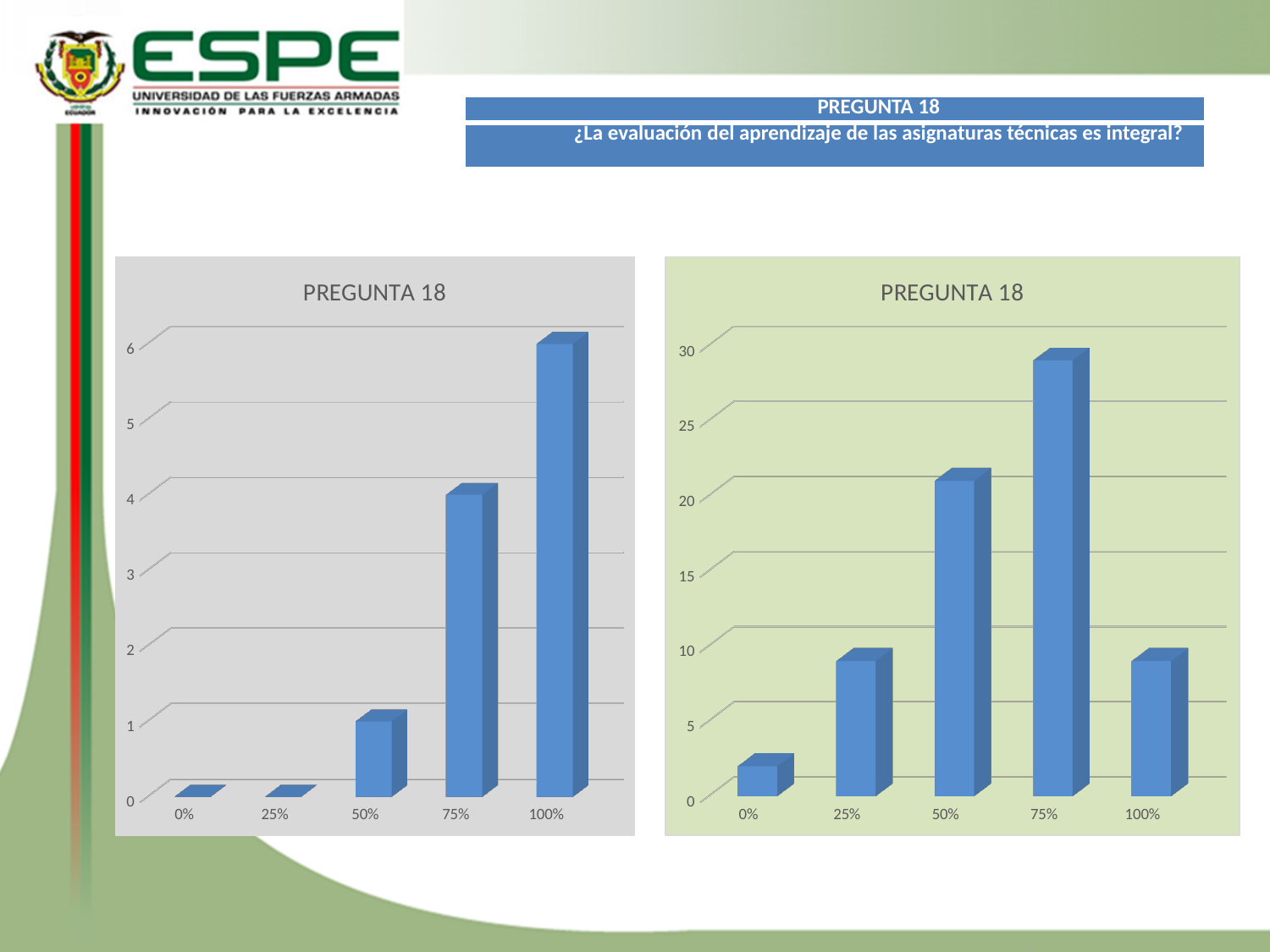
In the left chart, what is the value for the 100% category? 6 In the right chart, which is larger, the value for 50% or the value for 100%? 50% In the left chart, what is the difference between the values for 100% and 75%? 2 In the left chart, what is the value for the 75% category? 4 In the right chart, is the value for 25% greater or less than 10? less How many categories are shown on the x axis of the left chart? 5 In the right chart, which category has the highest value? 75% In the right chart, which category has the lowest value? 0% In the right chart, is the value for 50% greater or less than 20? greater In the left chart, what is the value for the 50% category? 1 In the left chart, which category has the highest value? 100% What type of chart is the left chart on the slide? bar chart